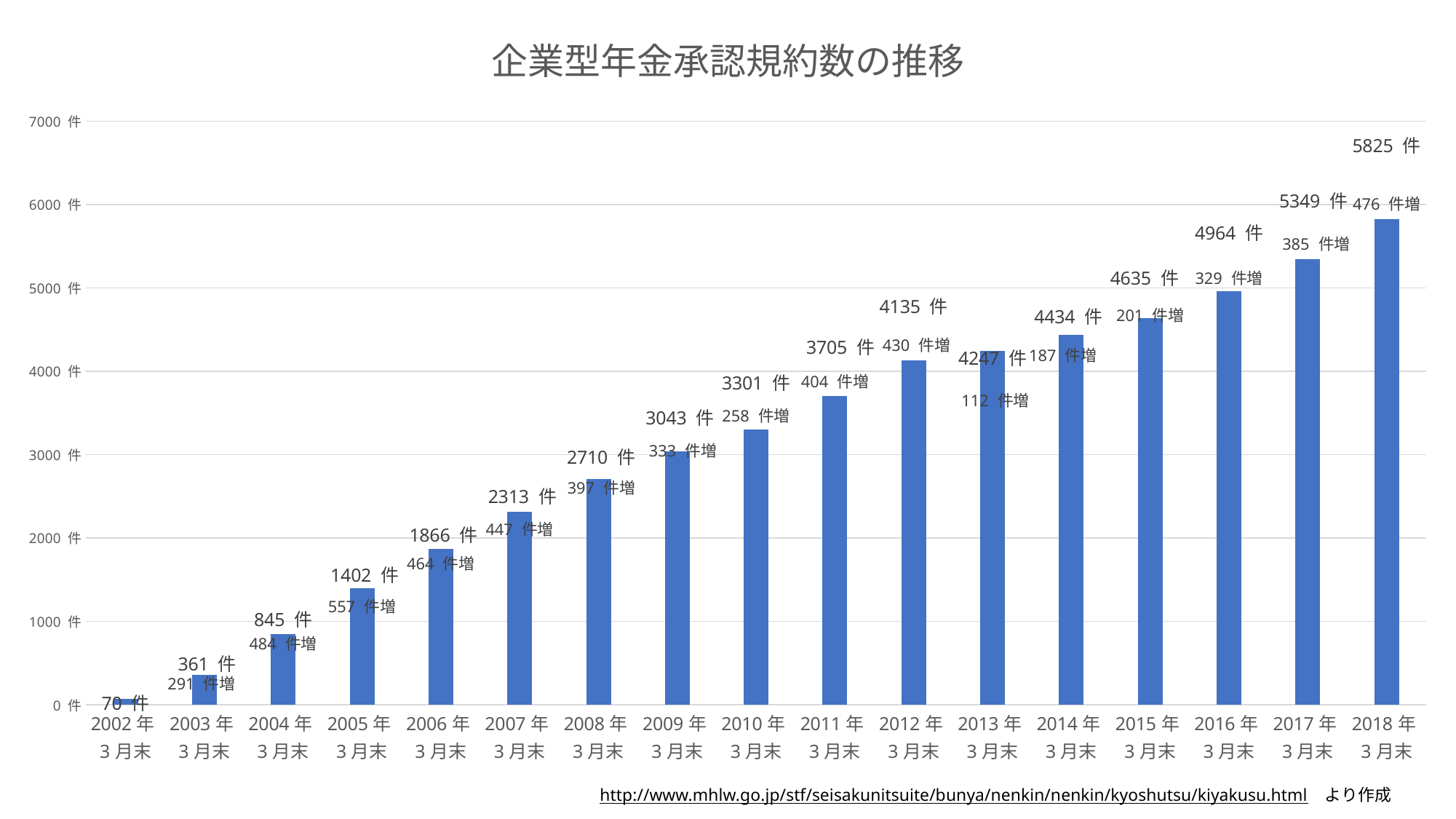
Do the values rise or fall from 2002年3月末 to 2018年3月末? rise What is the value for 2018年3月末? 5825 件 How many bars (year-end points) are shown in the chart? 17 What kind of chart is shown on the slide? bar chart What is the difference between the values for 2013年3月末 and 2012年3月末? 112 件 Which year-end has the highest number of approved plans? 2018年3月末 Which year-end has the lowest number of approved plans? 2002年3月末 Is the value for 2016年3月末 greater or less than 5000? less Which is larger, the value for 2009年3月末 or 2011年3月末? 2011年3月末 What is the value for 2002年3月末? 70 件 What is the value for 2010年3月末? 3301 件 What is the difference between the values for 2018年3月末 and 2017年3月末? 476 件